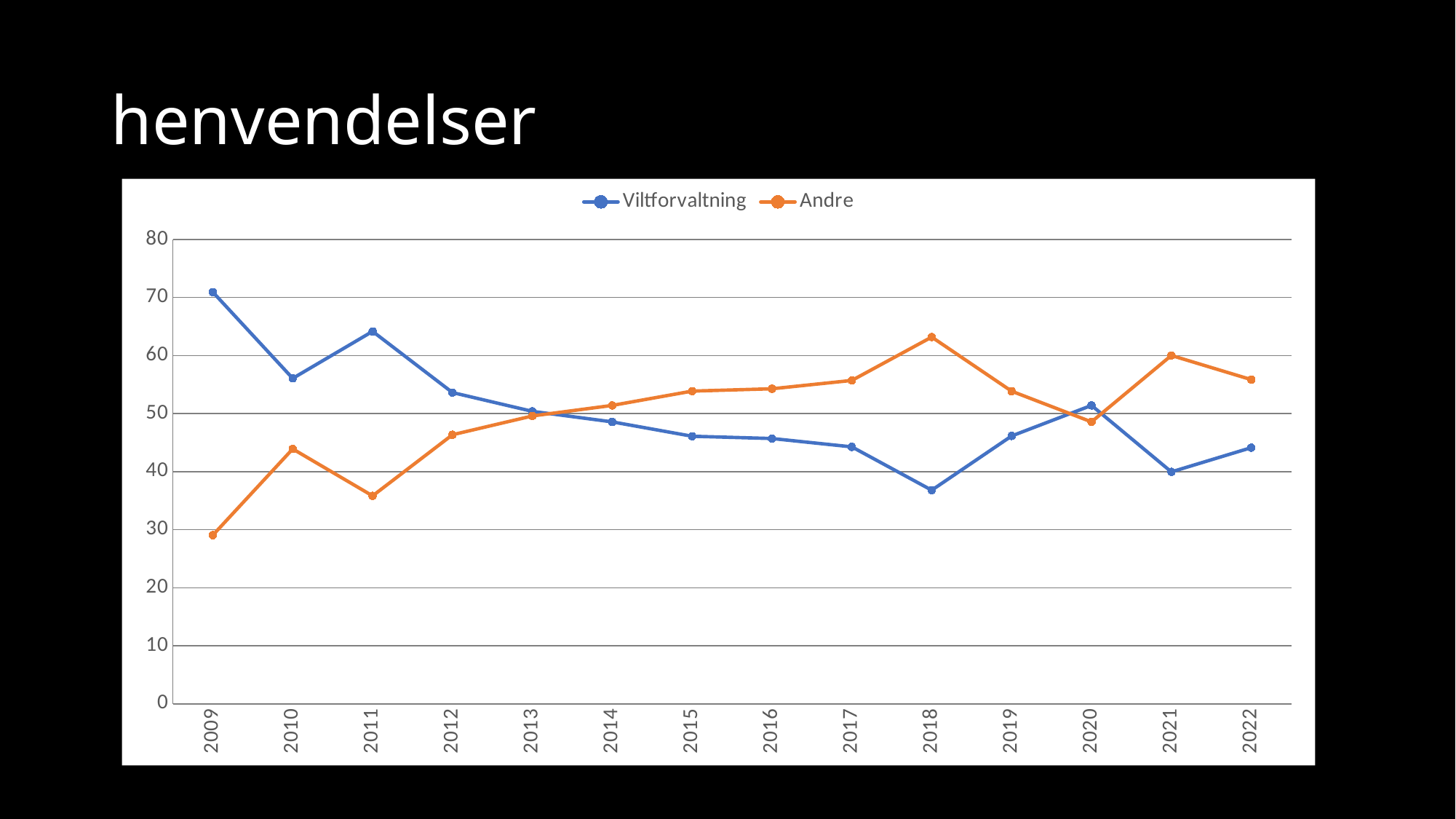
How many years are plotted along the x axis? 14 In which year is the Viltforvaltning series at its lowest? 2018 Is the value for Viltforvaltning in 2018 greater or less than 40? less What kind of chart is shown on the slide? line chart In which year is the Andre series at its lowest? 2009 Which series has the higher value in 2021, Viltforvaltning or Andre? Andre In which year is the Andre series at its highest? 2018 How many series does the legend list? 2 Is the value for Andre in 2018 greater or less than 60? greater Does the Viltforvaltning series rise or fall from 2009 to 2013? fall Is the value for Andre in 2011 greater or less than 40? less In which year is the Viltforvaltning series at its highest? 2009